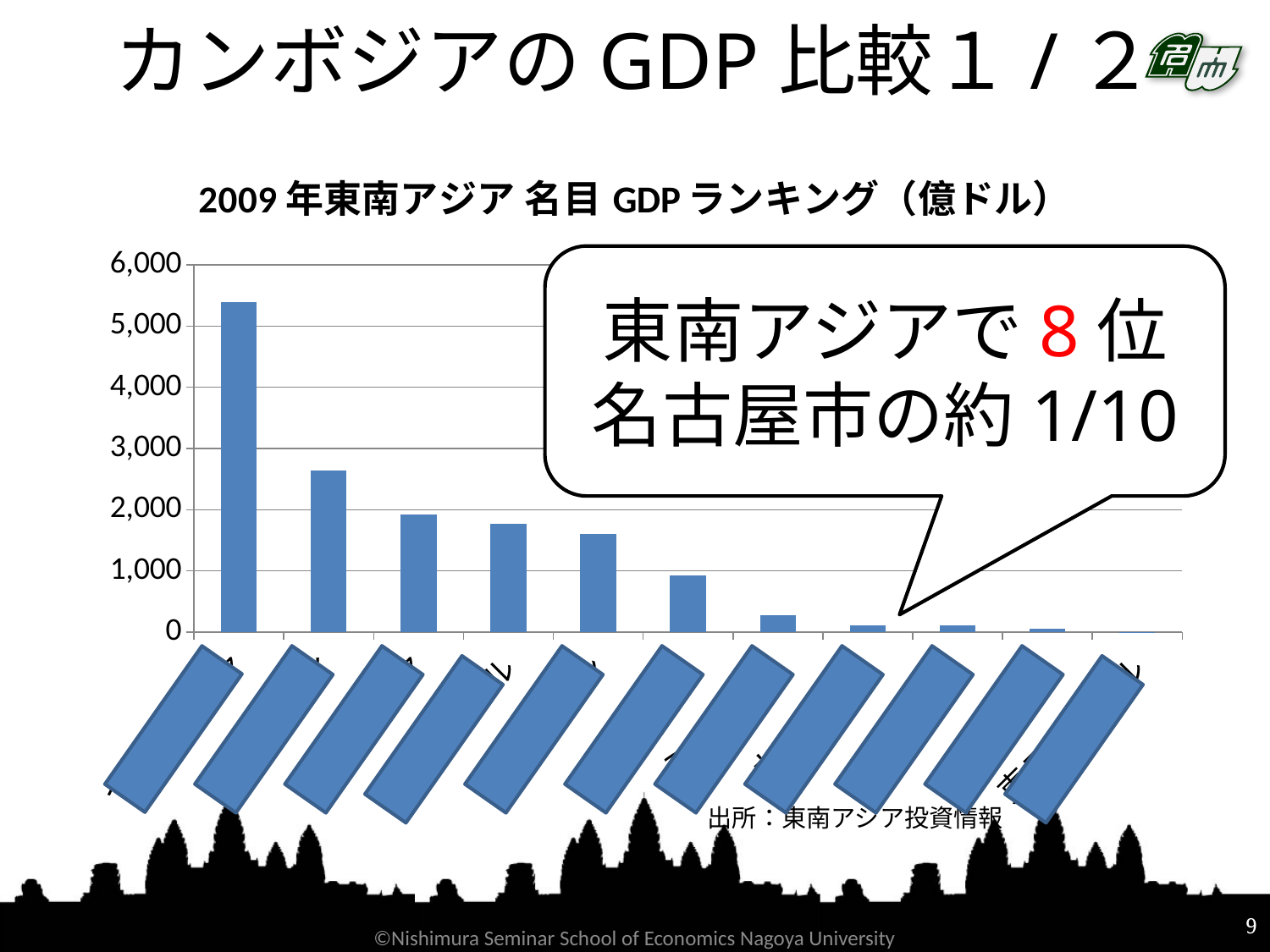
Do the bar values rise or fall from left to right along the x axis? fall Is the value of the tallest bar greater or less than 5,000? greater What is the highest value shown on the vertical axis? 6,000 What kind of chart is shown on the slide? bar chart Which bar is the tallest: the leftmost bar or the rightmost bar? the leftmost bar Is the value of the third bar from the left greater or less than 3,000? less Is the value of the sixth bar from the left greater or less than 1,000? less How many bars are plotted in the chart? 11 What is the title of the chart? 2009年東南アジア 名目GDPランキング（億ドル）